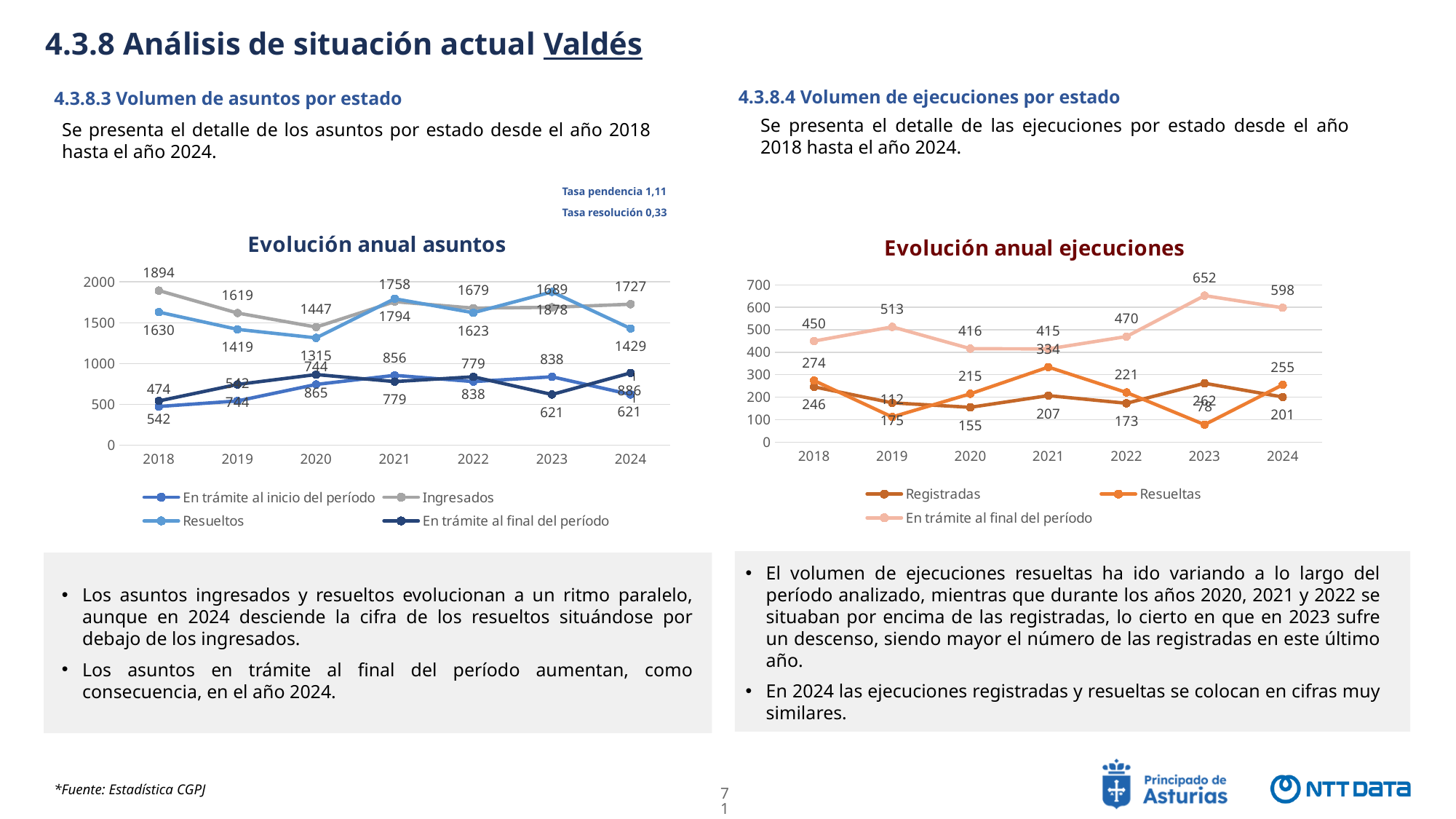
In the 'Evolución anual asuntos' chart, what is the value of Resueltos in 2024? 1429 In the 'Evolución anual asuntos' chart, what is the value of Ingresados in 2018? 1894 In the 'Evolución anual ejecuciones' chart, what is the difference between Registradas and Resueltas in 2023? 184 In the 'Evolución anual ejecuciones' chart, what is the value of Resueltas in 2021? 334 In the 'Evolución anual ejecuciones' chart, in which year is Resueltas lowest? 2023 In the 'Evolución anual ejecuciones' chart, does En trámite al final del período rise or fall from 2022 to 2023? Rise In the 'Evolución anual asuntos' chart, which is larger in 2024, Ingresados or Resueltos? Ingresados In the 'Evolución anual asuntos' chart, in which year is Ingresados lowest? 2020 What kind of chart is 'Evolución anual ejecuciones'? Line chart In the 'Evolución anual ejecuciones' chart, how many years are plotted on the x axis? 7 In the 'Evolución anual ejecuciones' chart, what is the value of En trámite al final del período in 2023? 652 In the 'Evolución anual asuntos' chart, how many series does the legend list? 4